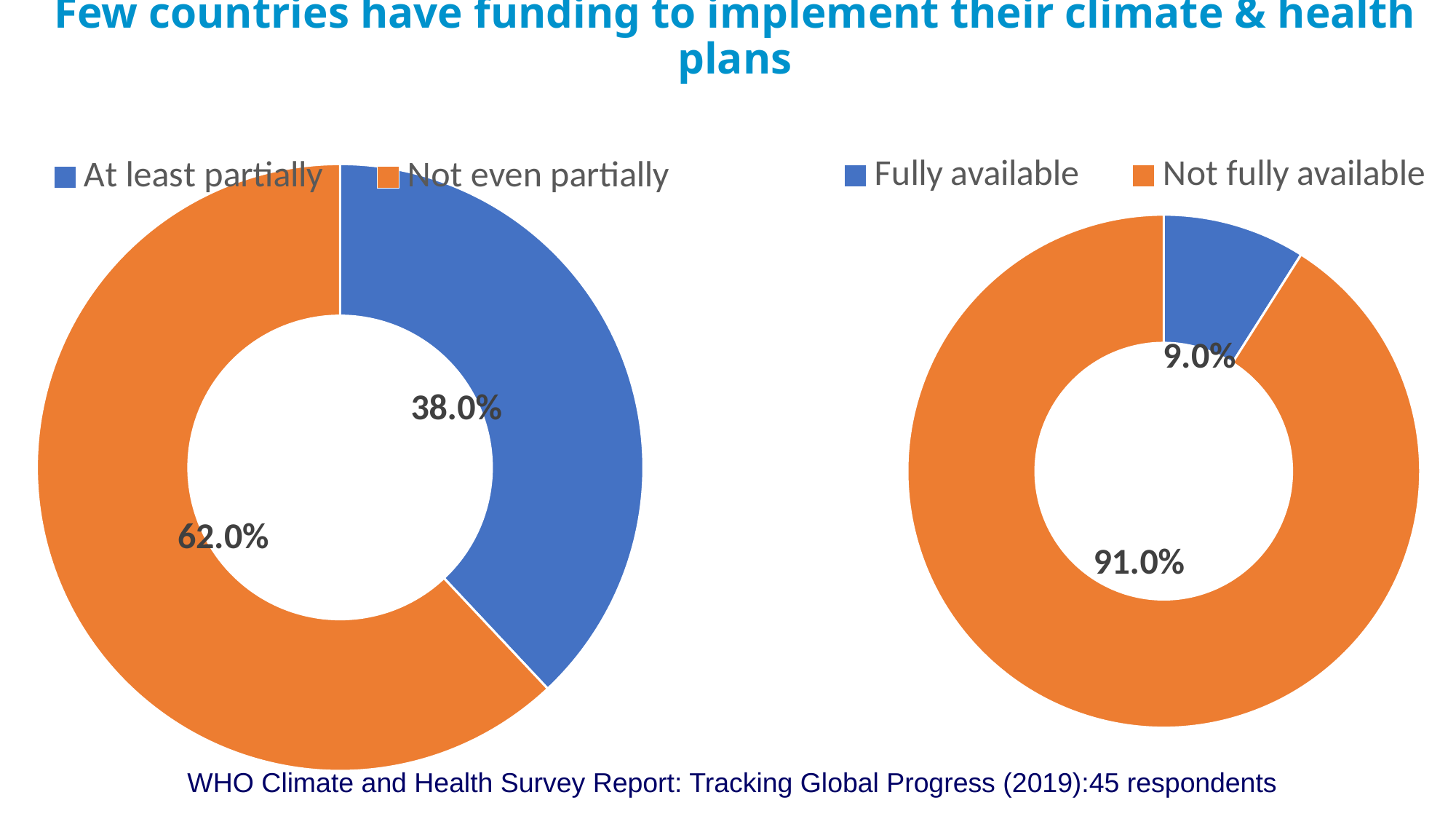
In the left chart, what percentage is labelled for 'Not even partially'? 62.0% In the left chart, what percentage is labelled for 'At least partially'? 38.0% In the right chart, what percentage is labelled for 'Fully available'? 9.0% How many categories does the legend of the right chart list? 2 What colour represents 'Not fully available' in the right chart? Orange Which is larger: 'At least partially' in the left chart or 'Fully available' in the right chart? At least partially In the right chart, what percentage is labelled for 'Not fully available'? 91.0% In the right chart, which category has the smaller share? Fully available In the left chart, which category has the larger share? Not even partially What type of chart is used on the left of the slide? Doughnut (pie) chart In the left chart, what is the difference between the 'Not even partially' and 'At least partially' shares? 24.0% In the right chart, what is the difference between the 'Not fully available' and 'Fully available' shares? 82.0%